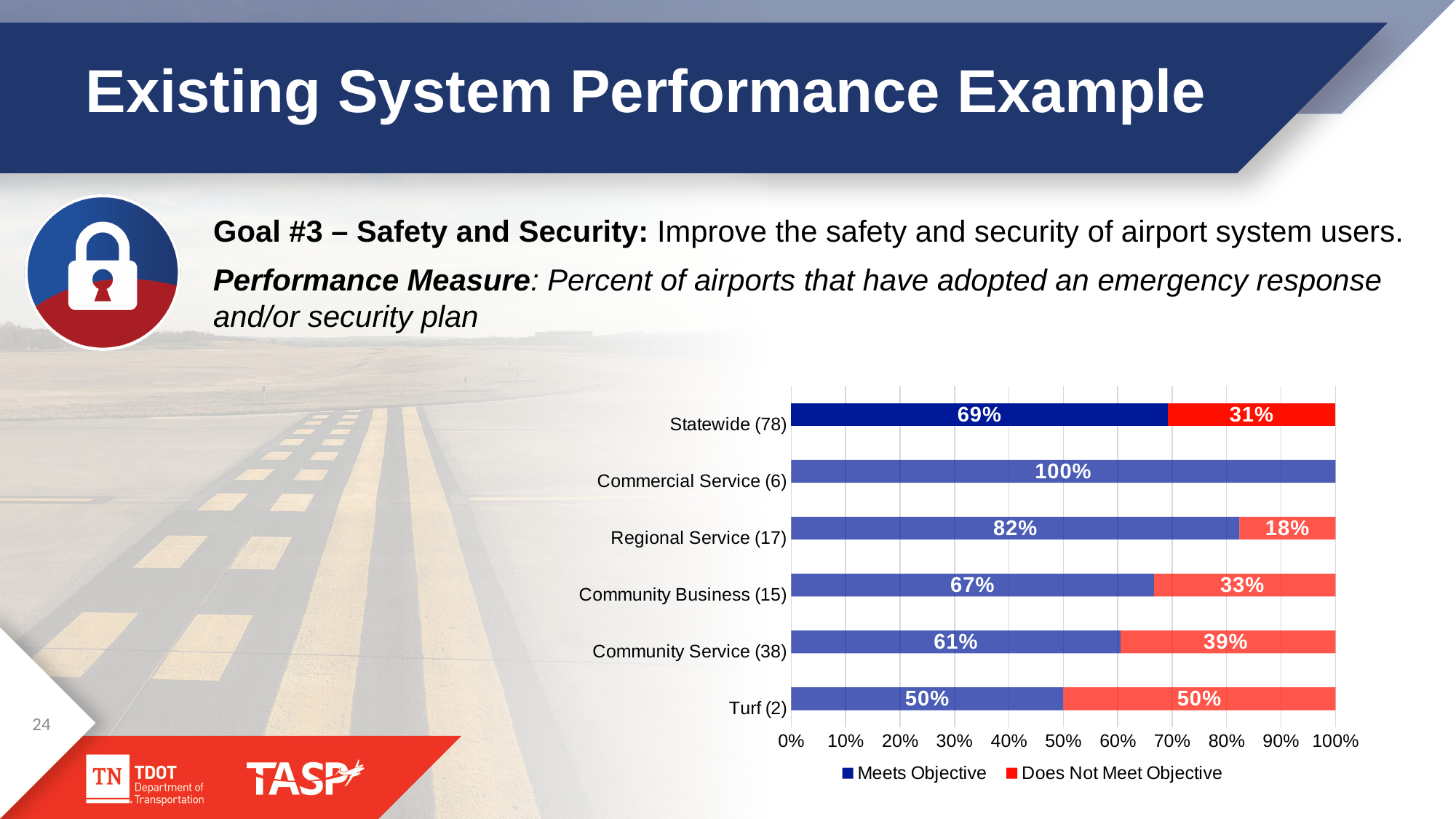
Which category has the highest 'Meets Objective' percentage? Commercial Service (6) What is the 'Meets Objective' value for Regional Service (17)? 82% How many categories are shown on the chart? 6 What is the 'Does Not Meet Objective' value for Community Service (38)? 39% How many series does the legend list? 2 What kind of chart is shown on the slide? Stacked bar chart Which category has the lowest 'Meets Objective' percentage? Turf (2) What is the difference between the 'Meets Objective' values for Regional Service (17) and Community Business (15)? 15% Which is larger: the 'Does Not Meet Objective' value for Community Business (15) or for Regional Service (17)? Community Business (15) What percentage of Statewide (78) airports meet the objective? 69% Which colour represents 'Does Not Meet Objective' in the legend? Red What is the total of the stacked bar for Community Service (38)? 100%